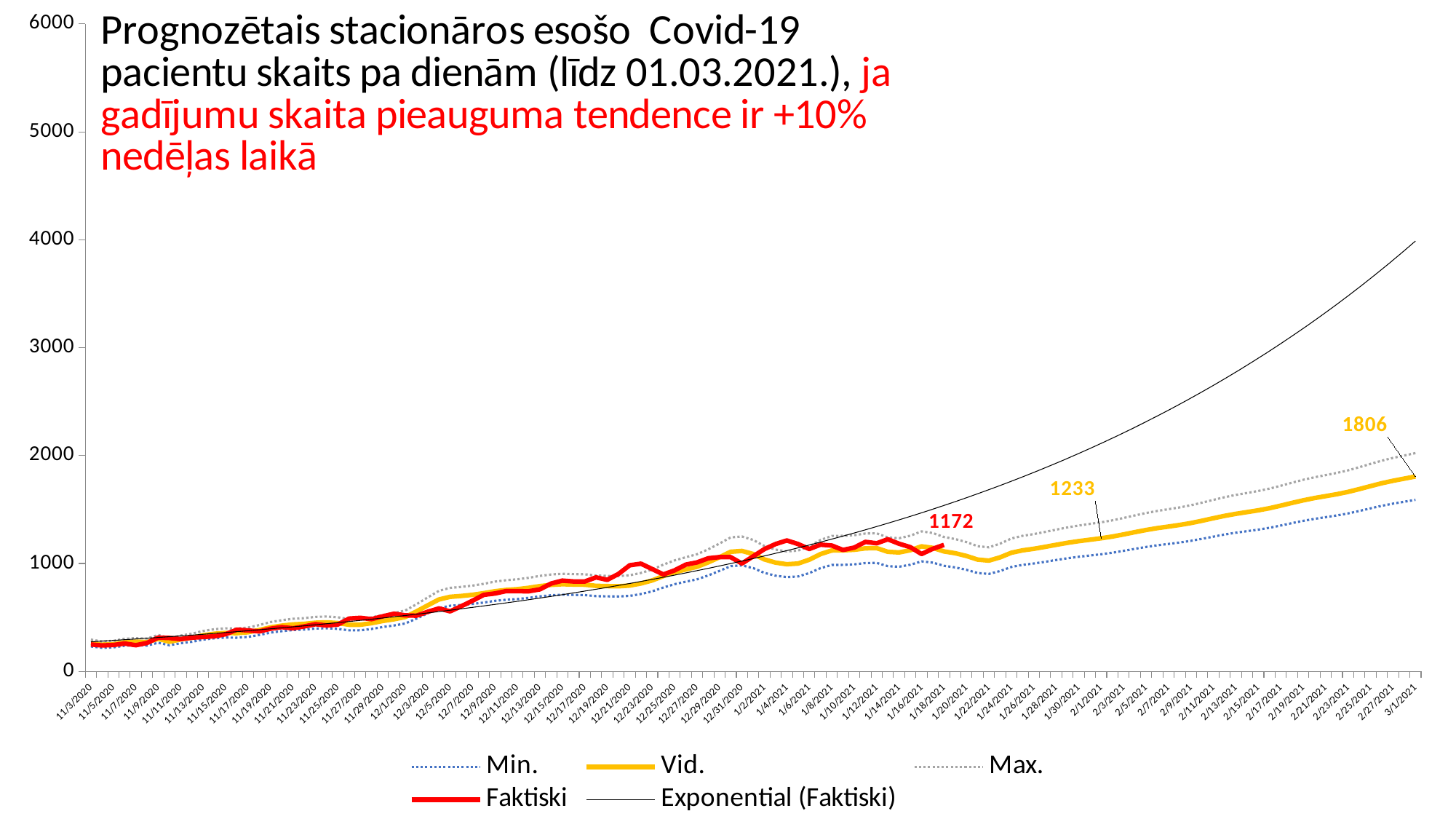
Is the value of the Exponential (Faktiski) series at 3/1/2021 greater or less than 3000? greater What kind of chart is shown on the slide? line chart Is the value of the Min. series at 3/1/2021 greater or less than 2000? less How many series does the legend list? 5 What is the labelled value of the Vid. series at 3/1/2021? 1806 What colour is the Faktiski line? red What is the difference between the two labelled values on the Vid. series, 1806 and 1233? 573 Which series has the lowest value at 3/1/2021? Min. What is the first (earlier) labelled value on the Vid. series? 1233 Does the Vid. series rise or fall from 11/3/2020 to 3/1/2021? rise Which series has the highest value at 3/1/2021? Exponential (Faktiski) What is the labelled value at the end of the Faktiski series? 1172